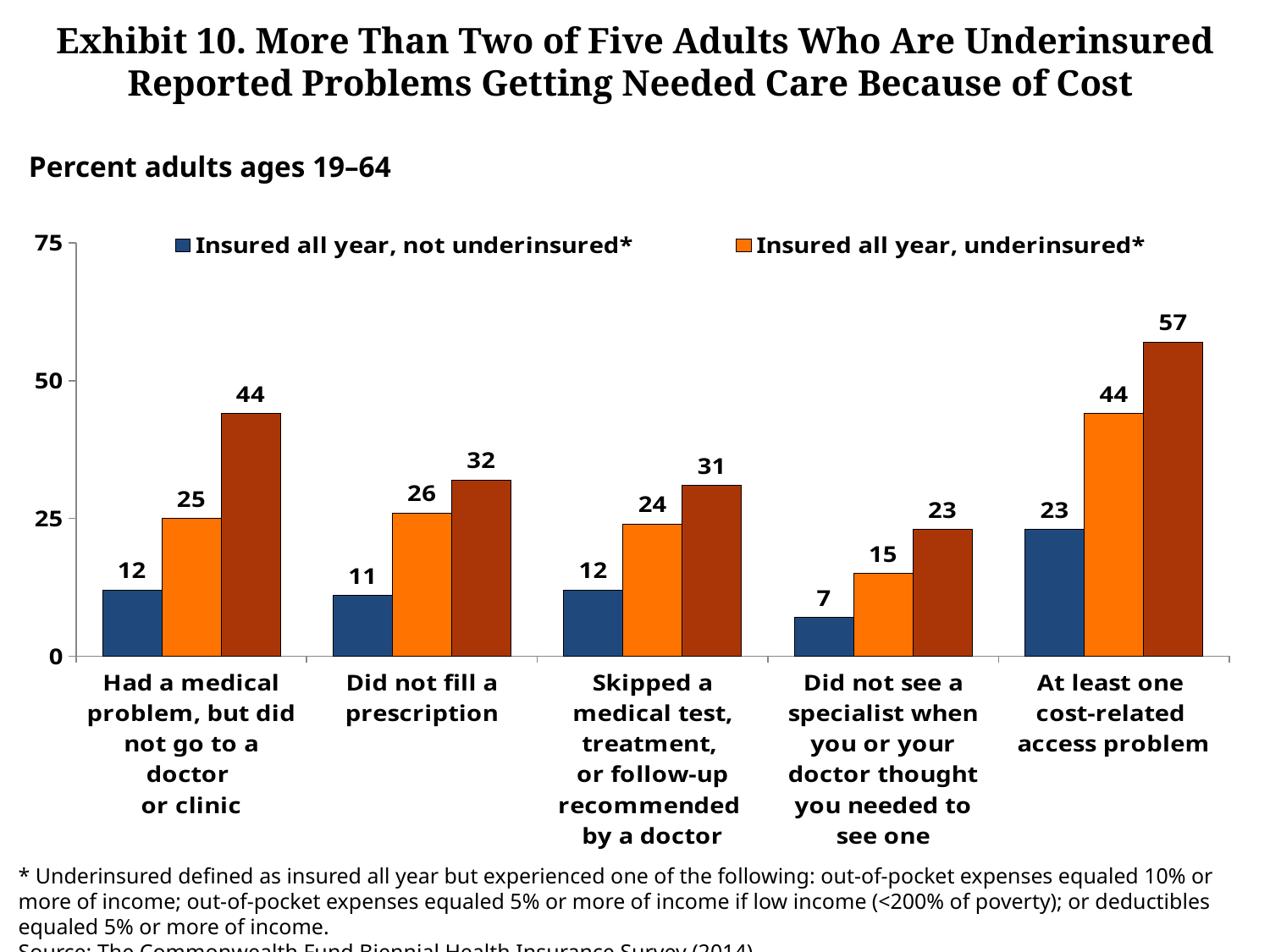
Which category has the highest value for 'Insured all year, not underinsured*'? At least one cost-related access problem What is the difference between 'Insured all year, underinsured*' and 'Insured all year, not underinsured*' for 'Had a medical problem, but did not go to a doctor or clinic'? 13 What kind of chart is shown on the slide? bar chart For 'Skipped a medical test, treatment, or follow-up recommended by a doctor', which is larger: 'Insured all year, underinsured*' or 'Insured all year, not underinsured*'? Insured all year, underinsured* Which category has the lowest value for 'Insured all year, underinsured*'? Did not see a specialist when you or your doctor thought you needed to see one How many categories are shown on the x axis? 5 What is the value for 'Insured all year, underinsured*' for 'At least one cost-related access problem'? 44 How many series does the legend list? 2 What is the highest value shown on the vertical axis? 75 What is the value for 'Insured all year, not underinsured*' for 'Did not see a specialist when you or your doctor thought you needed to see one'? 7 Is the value for 'Insured all year, underinsured*' for 'At least one cost-related access problem' greater or less than 25? greater What is the value for 'Insured all year, underinsured*' for 'Did not fill a prescription'? 26